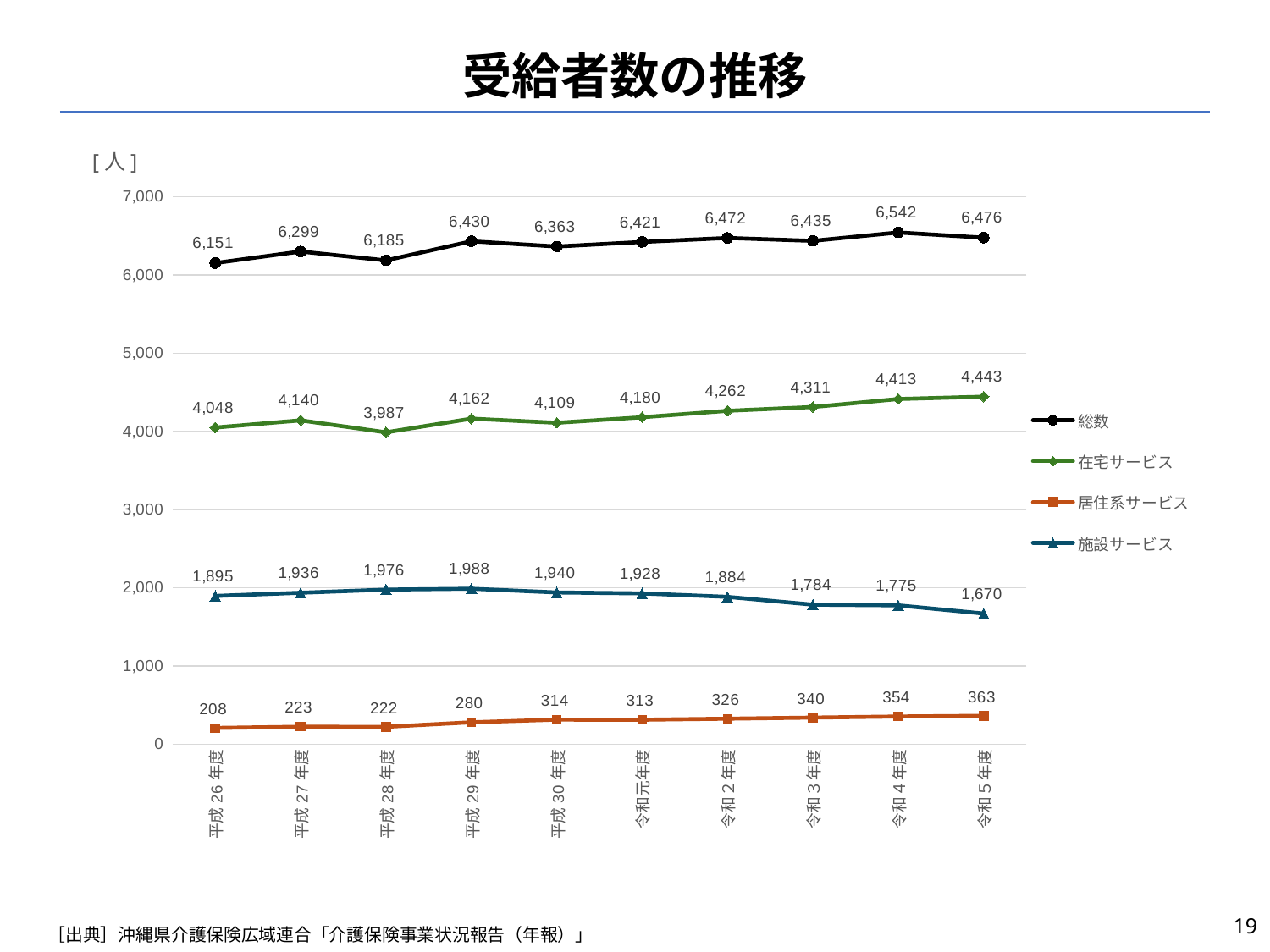
Does 施設サービス rise or fall from 平成29年度 to 令和5年度? Fall What is the value of 施設サービス for 平成29年度? 1,988 What is the unit shown above the y axis? 人 How many fiscal years are plotted on the x axis? 10 What is the value of 総数 for 令和5年度? 6,476 What kind of chart is shown on the slide? Line chart Which is larger: 施設サービス in 平成26年度 or in 令和5年度? 平成26年度 In which fiscal year is 居住系サービス lowest? 平成26年度 What is the value of 在宅サービス for 平成28年度? 3,987 In which fiscal year is 総数 highest? 令和4年度 What is the difference between 在宅サービス in 令和5年度 and 平成26年度? 395 How many series does the legend list? 4